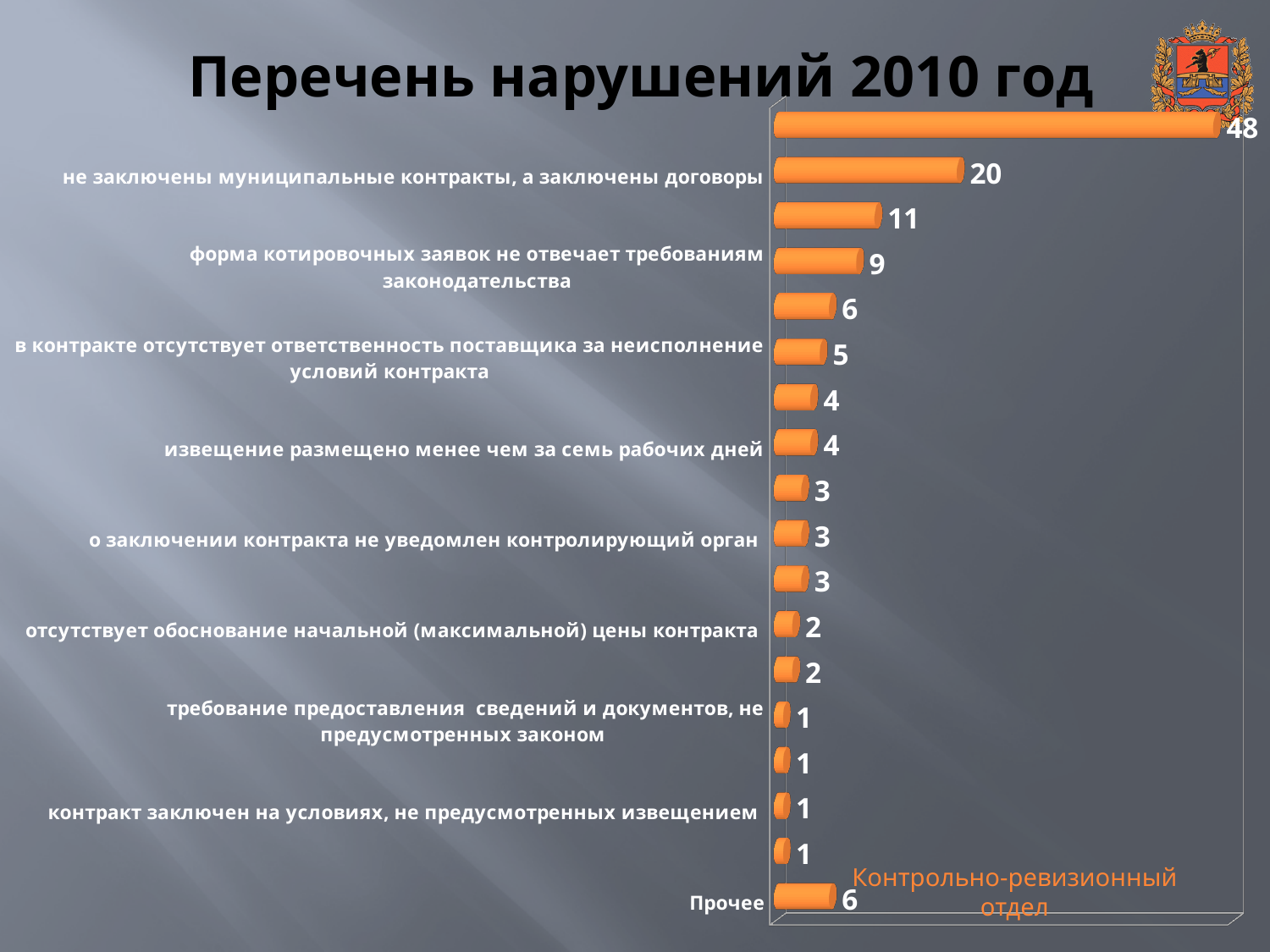
What is the value for 'в контракте отсутствует ответственность поставщика за неисполнение условий контракта'? 5 What is the value for 'форма котировочных заявок не отвечает требованиям законодательства'? 9 What is the difference between the values for 'не заключены муниципальные контракты, а заключены договоры' and 'форма котировочных заявок не отвечает требованиям законодательства'? 11 What is the value for 'Прочее'? 6 Which is larger: the value for 'Прочее' or the value for 'о заключении контракта не уведомлен контролирующий орган'? Прочее What is the largest value labelled on any bar in the chart? 48 What colour are the bars in the chart? orange How many bars are plotted in the chart? 18 What is the title of the slide chart? Перечень нарушений 2010 год What is the value for 'не заключены муниципальные контракты, а заключены договоры'? 20 What is the value for 'извещение размещено менее чем за семь рабочих дней'? 4 What type of chart is shown on the slide? bar chart